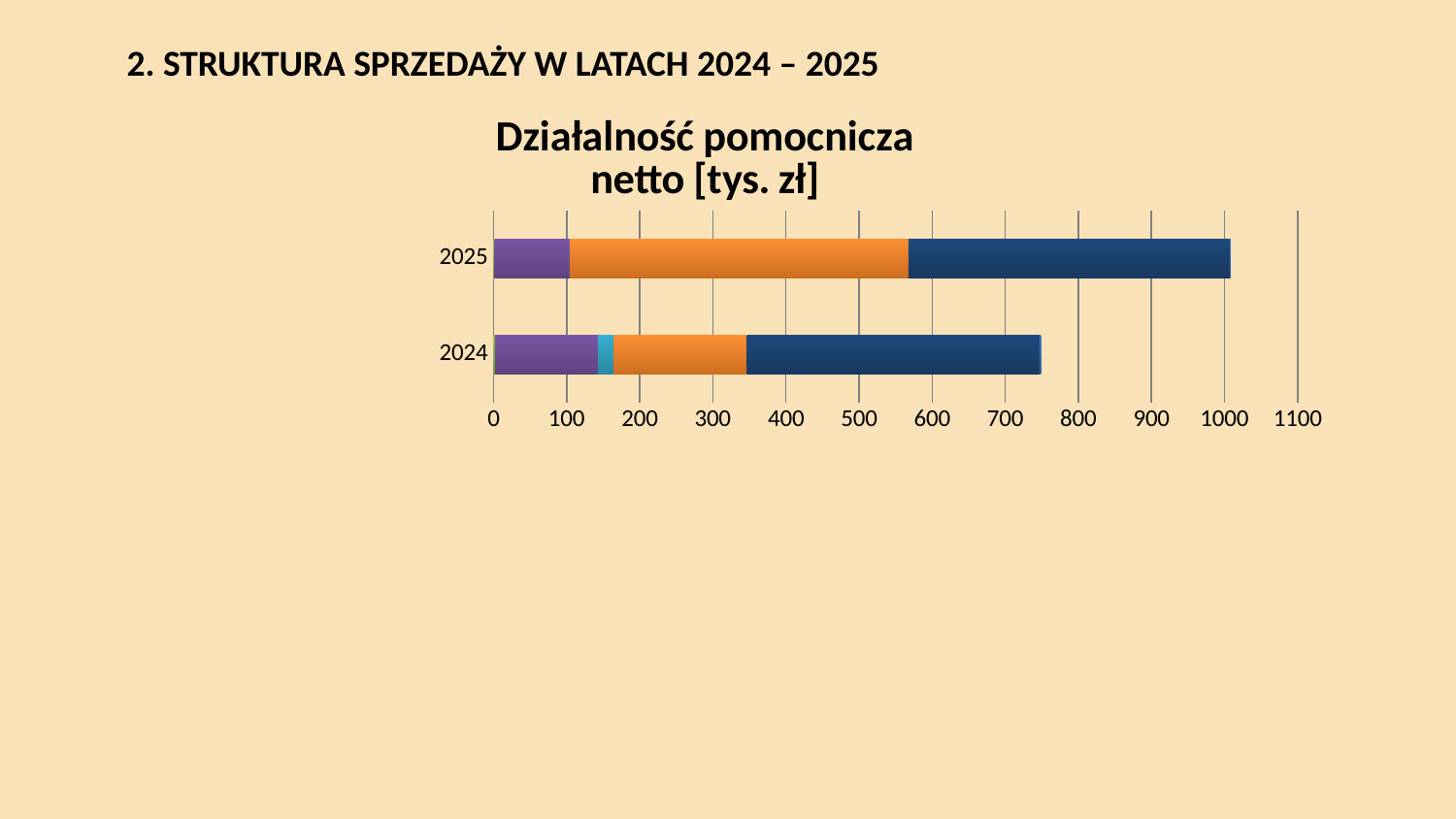
What is the title of the chart? Działalność pomocnicza netto [tys. zł] Does the total value rise or fall from 2024 to 2025? rise Which year has the highest total value? 2025 Is the total value for 2025 greater or less than 900? greater What is the highest value shown on the horizontal axis? 1100 What kind of chart is shown on the slide? Stacked bar chart How many categories (years) are shown on the chart? 2 Is the total value for 2024 greater or less than 700? greater Which year has the longer total bar, 2024 or 2025? 2025 Is the total value for 2024 greater or less than 800? less Which year has the lowest total value? 2024